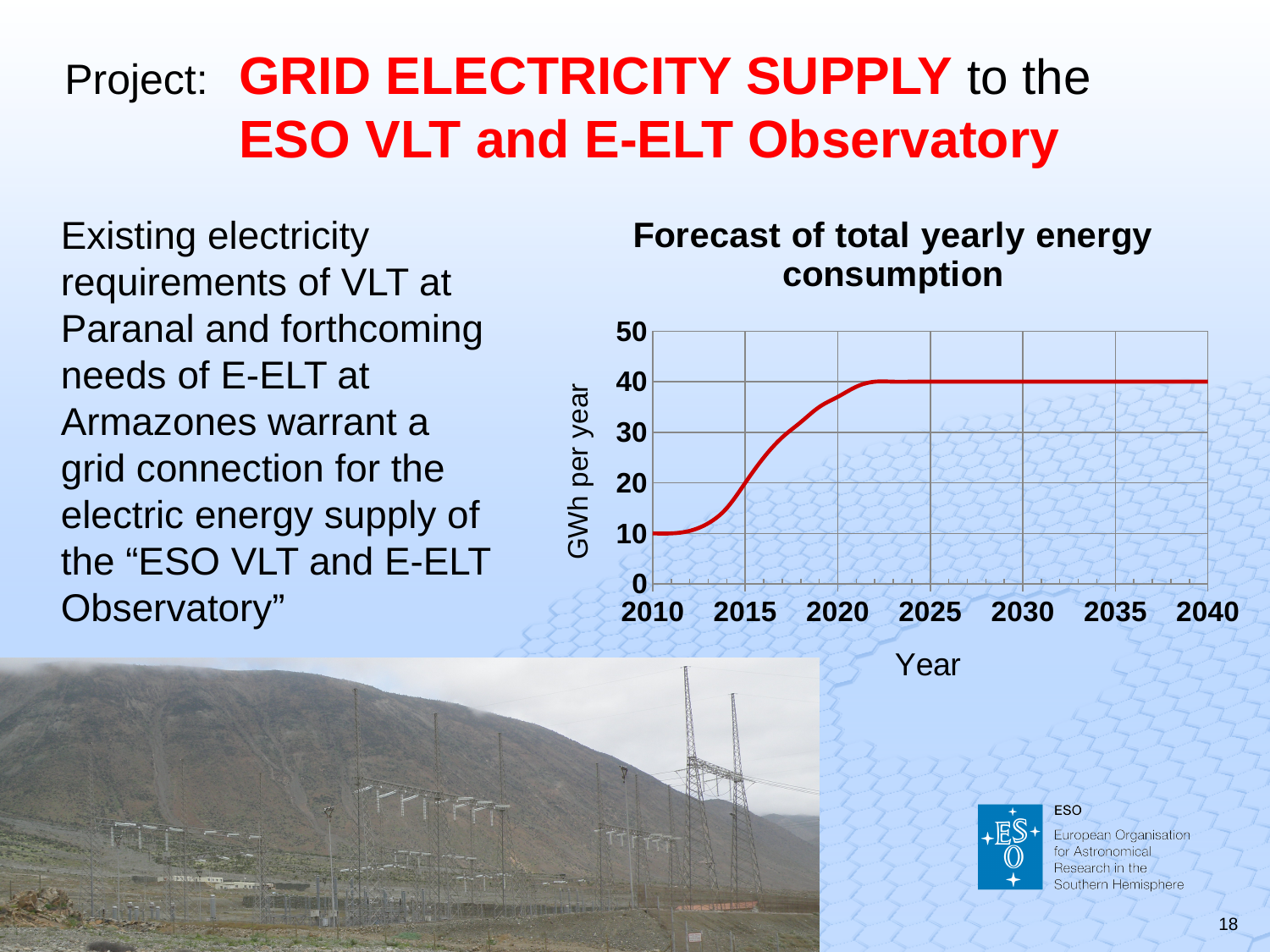
What is the highest value shown on the y axis of the chart? 50 Does the forecast energy consumption rise or fall between 2010 and 2025? rise What kind of chart is shown on the slide? line chart What is the title of the chart? Forecast of total yearly energy consumption Is the forecast energy consumption in 2020 greater or less than 30? greater What is the forecast energy consumption in 2040? 40 By how much does the forecast energy consumption increase between 2010 and 2040? 30 What is the forecast energy consumption in 2010? 10 Which year has the lower forecast energy consumption, 2010 or 2025? 2010 What is the label of the y axis of the chart? GWh per year What is the forecast energy consumption in 2030? 40